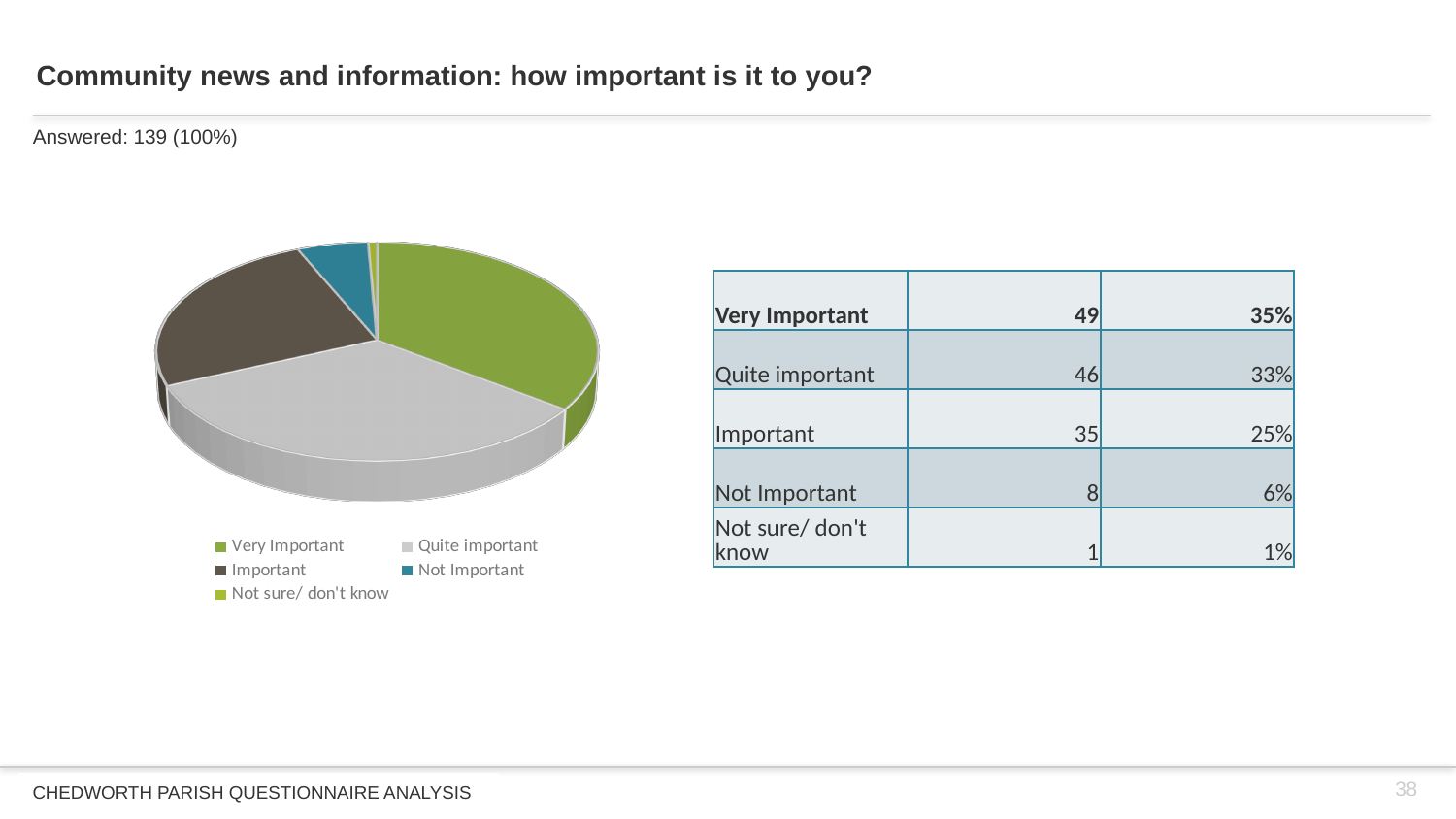
How many respondents answered 'Not Important'? 8 What colour is the 'Quite important' slice in the pie chart? grey What percentage of respondents answered 'Quite important'? 33% Which category has the largest slice of the pie chart? Very Important Which has more respondents, 'Important' or 'Not Important'? Important Which category has the smallest slice of the pie chart? Not sure/ don't know What kind of chart is shown on the slide? pie chart What share of the pie does 'Important' represent? 25% How many categories does the pie chart's legend list? 5 How many respondents answered 'Very Important'? 49 What is the difference in respondent counts between 'Very Important' and 'Quite important'? 3 How many people answered the question in total? 139